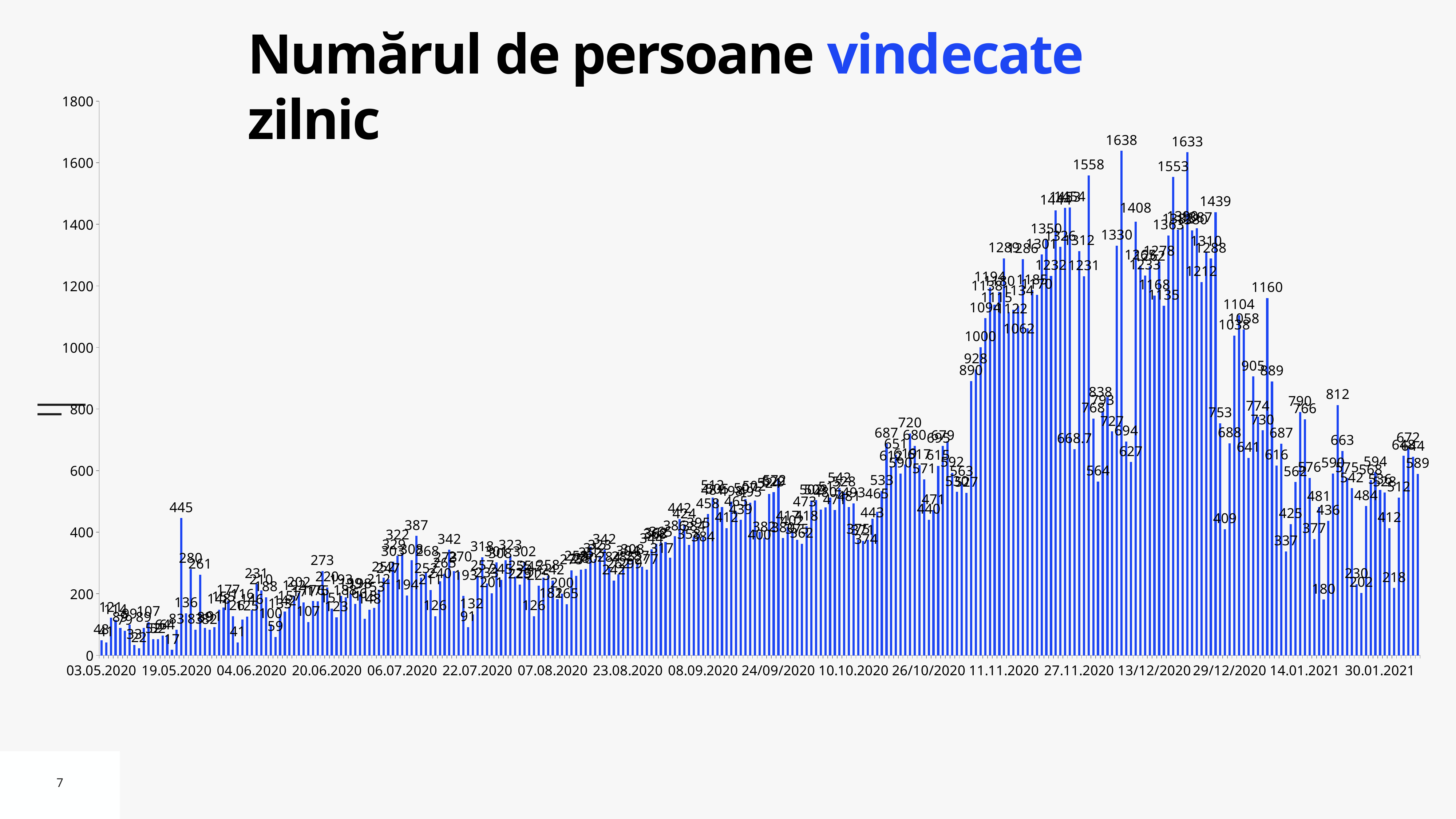
Which is larger, the bar labelled 812 or the bar labelled 790? 812 What is the value of the tallest bar in the chart? 1638 What is the last date label shown on the x axis? 30.01.2021 Which is larger, the bar labelled 445 or the bar labelled 387? 445 Is the value of the tallest bar greater or less than 1600? greater What is the value of the second tallest bar in the chart? 1633 What is the difference between the bars labelled 1638 and 1558? 80 What is the title of the chart? Numărul de persoane vindecate zilnic Do the values generally rise or fall along the x axis from 03.05.2020 to 11.11.2020? rise What is the difference between the two tallest bars, labelled 1638 and 1633? 5 What is the highest value shown on the y axis? 1800 What kind of chart is shown on the slide? bar chart